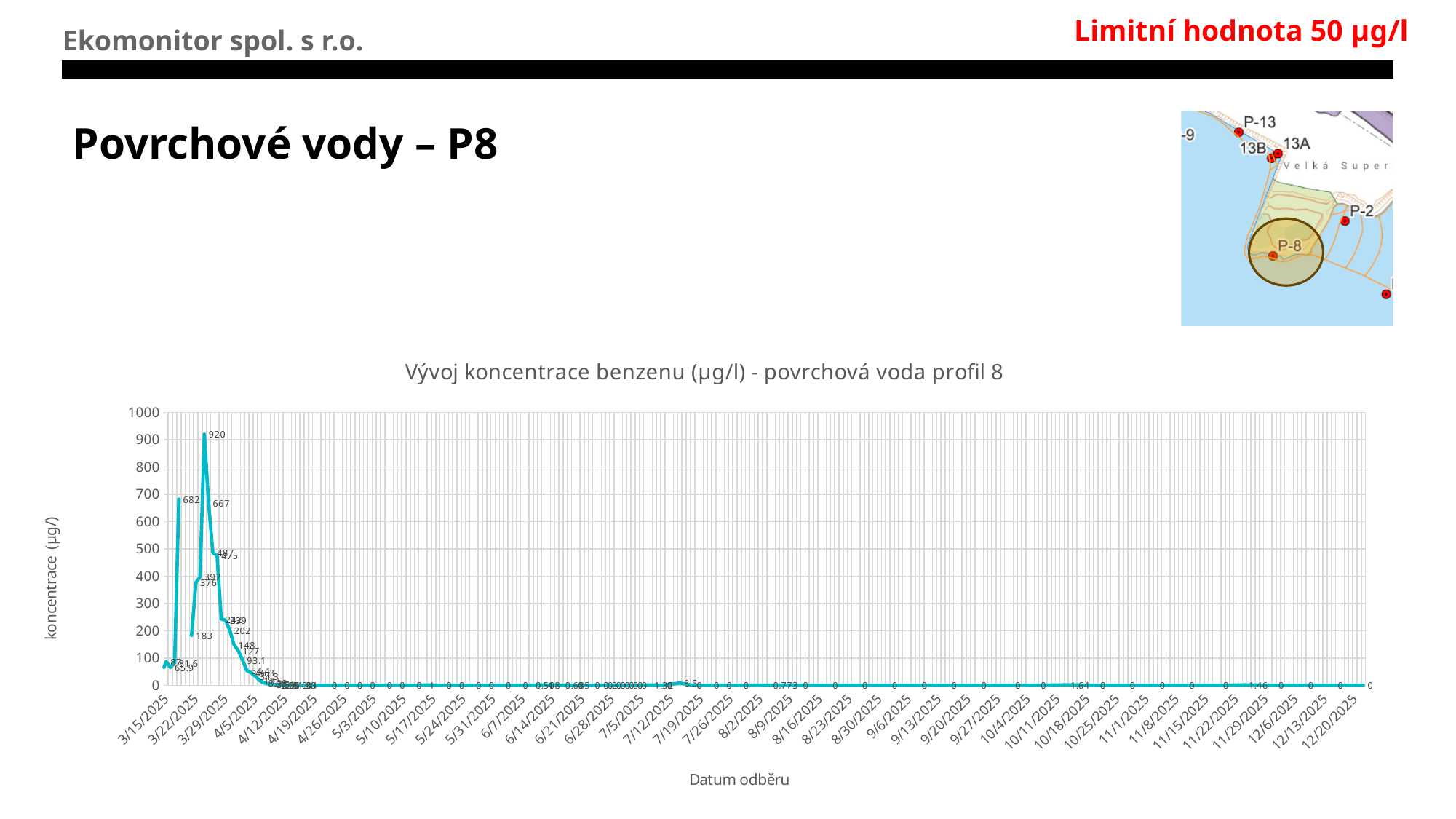
Is the peak benzene concentration value greater or less than 900? greater What is the difference between the highest labelled value (920) and the labelled value 682? 238 What is the highest benzene concentration value labelled on the chart? 920 What is the maximum value shown on the vertical axis of the chart? 1000 What is the title of the chart? Vývoj koncentrace benzenu (µg/l) - povrchová voda profil 8 What is the label of the vertical axis of the chart? koncentrace (µg/l) What is the labelled value of the last data point on the chart, at 12/20/2025? 0 Do the benzene concentration values rise or fall along the x axis after the peak in late March 2025? fall Is the benzene concentration value at 9/6/2025 greater or less than 100? less What kind of chart is shown on the slide? line chart Which labelled value is larger, 682 or 667? 682